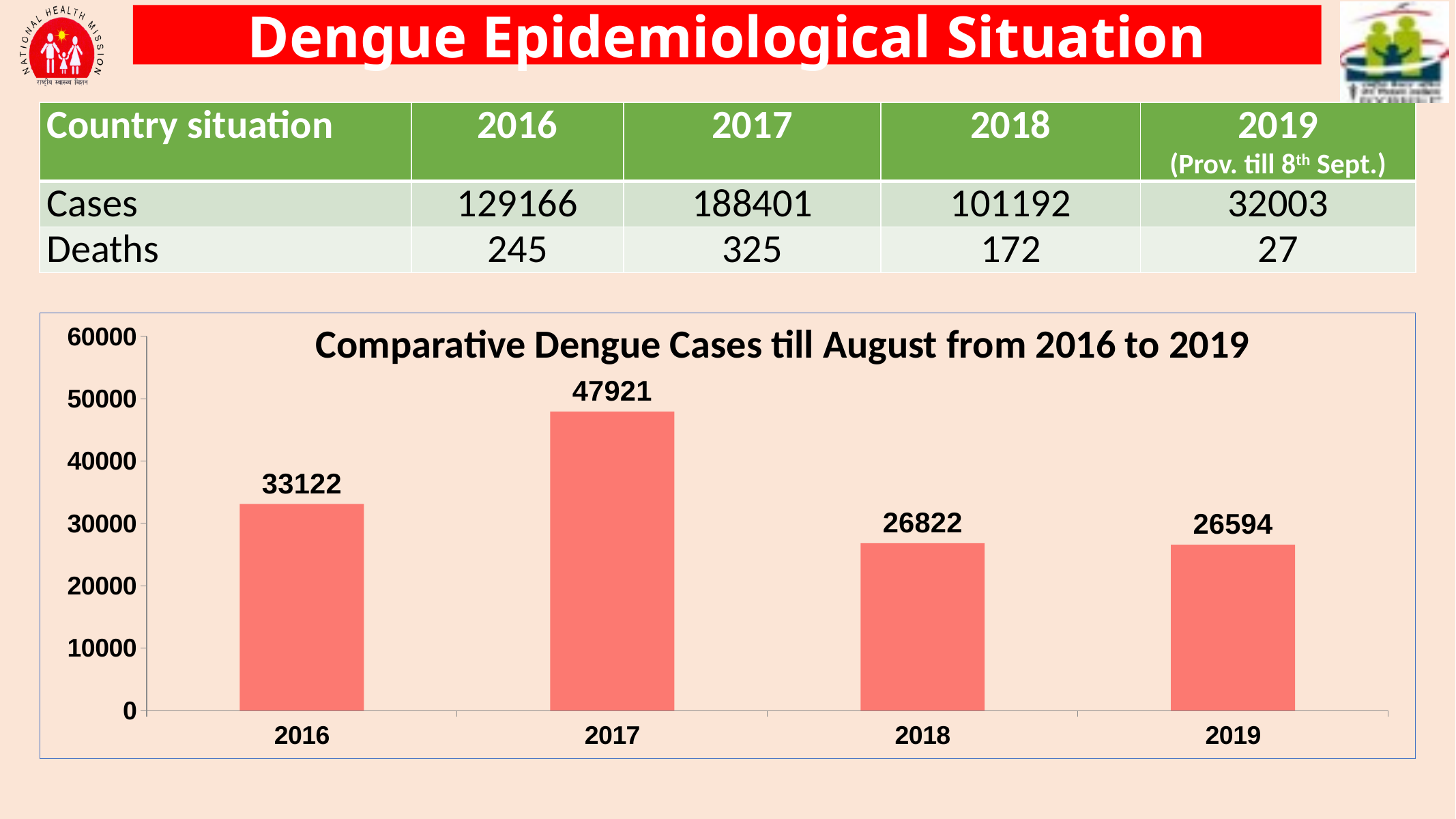
What is the value for 2017 in the chart? 47921 What is the title of the chart? Comparative Dengue Cases till August from 2016 to 2019 What kind of chart is shown on the slide? bar chart Which is larger in the chart, the value for 2016 or the value for 2018? 2016 What is the value for 2019 in the chart? 26594 Is the value for 2017 in the chart greater or less than 40000? greater What is the difference between the values for 2017 and 2016 in the chart? 14799 How many years are shown on the x axis of the chart? 4 What is the value for 2016 in the chart? 33122 Which year has the lowest number of dengue cases in the chart? 2019 Which year has the highest number of dengue cases in the chart? 2017 What is the difference between the values for 2018 and 2019 in the chart? 228